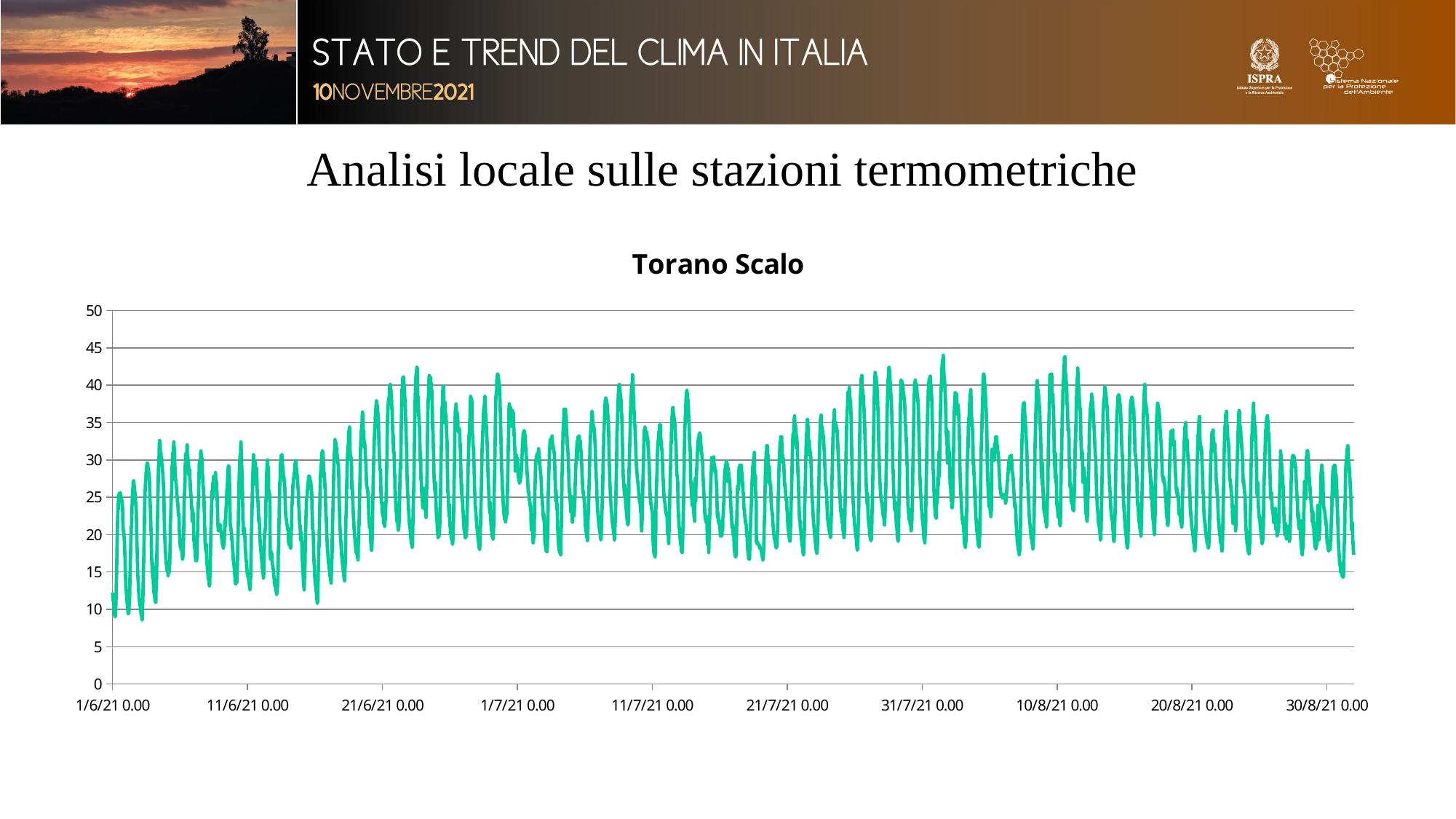
Is the value at the start of the series (1/6/21) greater or less than 20? less What is the first date label on the x axis? 1/6/21 0.00 Does the plotted line ever rise above 40? yes Does the plotted line ever rise above 50? no What is the title of the chart? Torano Scalo In which month does the series reach its lowest value? June How many series are plotted on the chart? 1 What is the last date label on the x axis? 30/8/21 0.00 What colour is the plotted line? green How many date labels are shown on the x axis? 10 What is the highest value shown on the y axis? 50 What kind of chart is shown on the slide? line chart